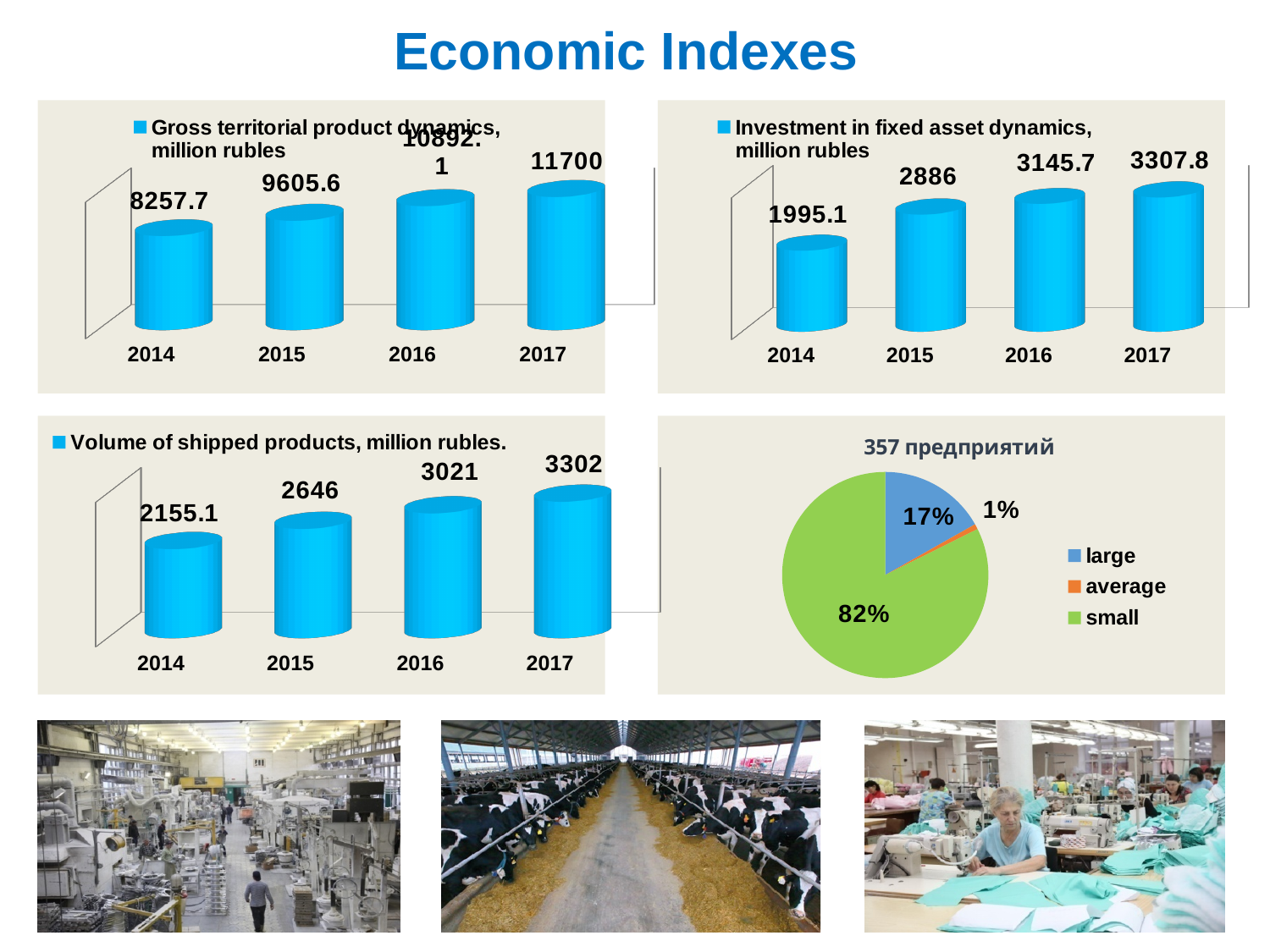
In the 'Gross territorial product dynamics, million rubles' chart, what is the value for 2015? 9605.6 In the pie chart titled '357 предприятий', what share is labelled 'small'? 82% In the 'Investment in fixed asset dynamics, million rubles' chart, do the values rise or fall from 2014 to 2017? rise In the pie chart titled '357 предприятий', which category has the smallest share? average In the 'Gross territorial product dynamics, million rubles' chart, what is the difference between the 2017 and 2014 values? 3442.3 In the 'Gross territorial product dynamics, million rubles' chart, which year has the highest value? 2017 In the 'Volume of shipped products, million rubles' chart, how many years are shown? 4 In the 'Investment in fixed asset dynamics, million rubles' chart, which year has the lowest value? 2014 In the 'Investment in fixed asset dynamics, million rubles' chart, what is the value for 2016? 3145.7 In the 'Volume of shipped products, million rubles' chart, what is the value for 2014? 2155.1 What kind of chart is the 'Gross territorial product dynamics, million rubles' chart? bar chart In the 'Volume of shipped products, million rubles' chart, what is the difference between the 2017 and 2016 values? 281